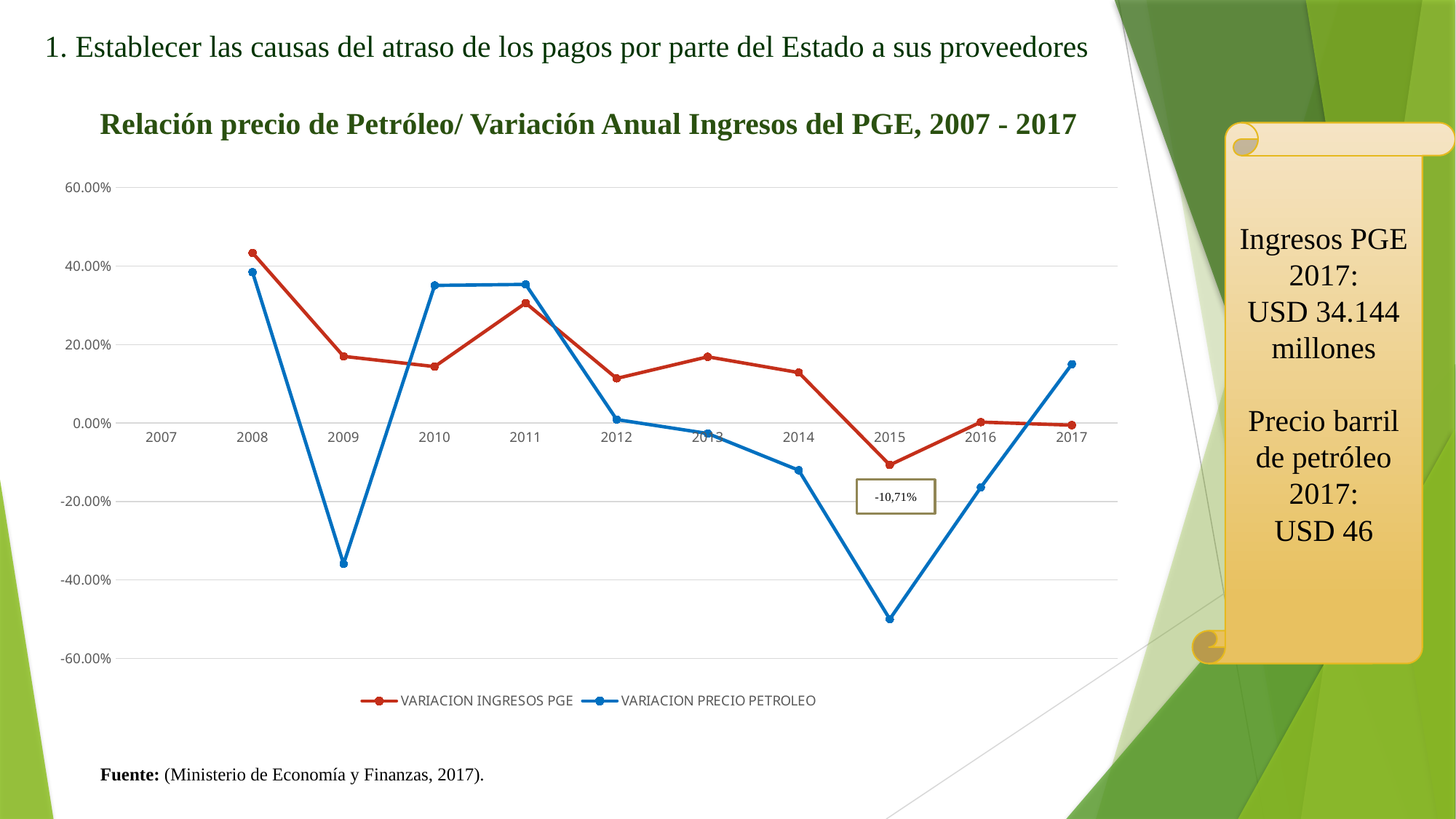
In which year does VARIACION PRECIO PETROLEO reach its lowest value? 2015 Is the value for VARIACION PRECIO PETROLEO in 2017 greater or less than 0.00%? greater How many series does the legend list? 2 Does VARIACION PRECIO PETROLEO rise or fall from 2015 to 2017? rise Is the value for VARIACION PRECIO PETROLEO in 2009 greater or less than -20.00%? less What is the value of VARIACION INGRESOS PGE in 2015? -10,71% In 2010, which series has the higher value, VARIACION INGRESOS PGE or VARIACION PRECIO PETROLEO? VARIACION PRECIO PETROLEO In 2009, which series has the higher value, VARIACION INGRESOS PGE or VARIACION PRECIO PETROLEO? VARIACION INGRESOS PGE What kind of chart is shown on the slide? line chart What is the title of the chart? Relación precio de Petróleo/ Variación Anual Ingresos del PGE, 2007 - 2017 In which year does VARIACION INGRESOS PGE reach its highest value? 2008 Is the value for VARIACION INGRESOS PGE in 2008 greater or less than 40.00%? greater